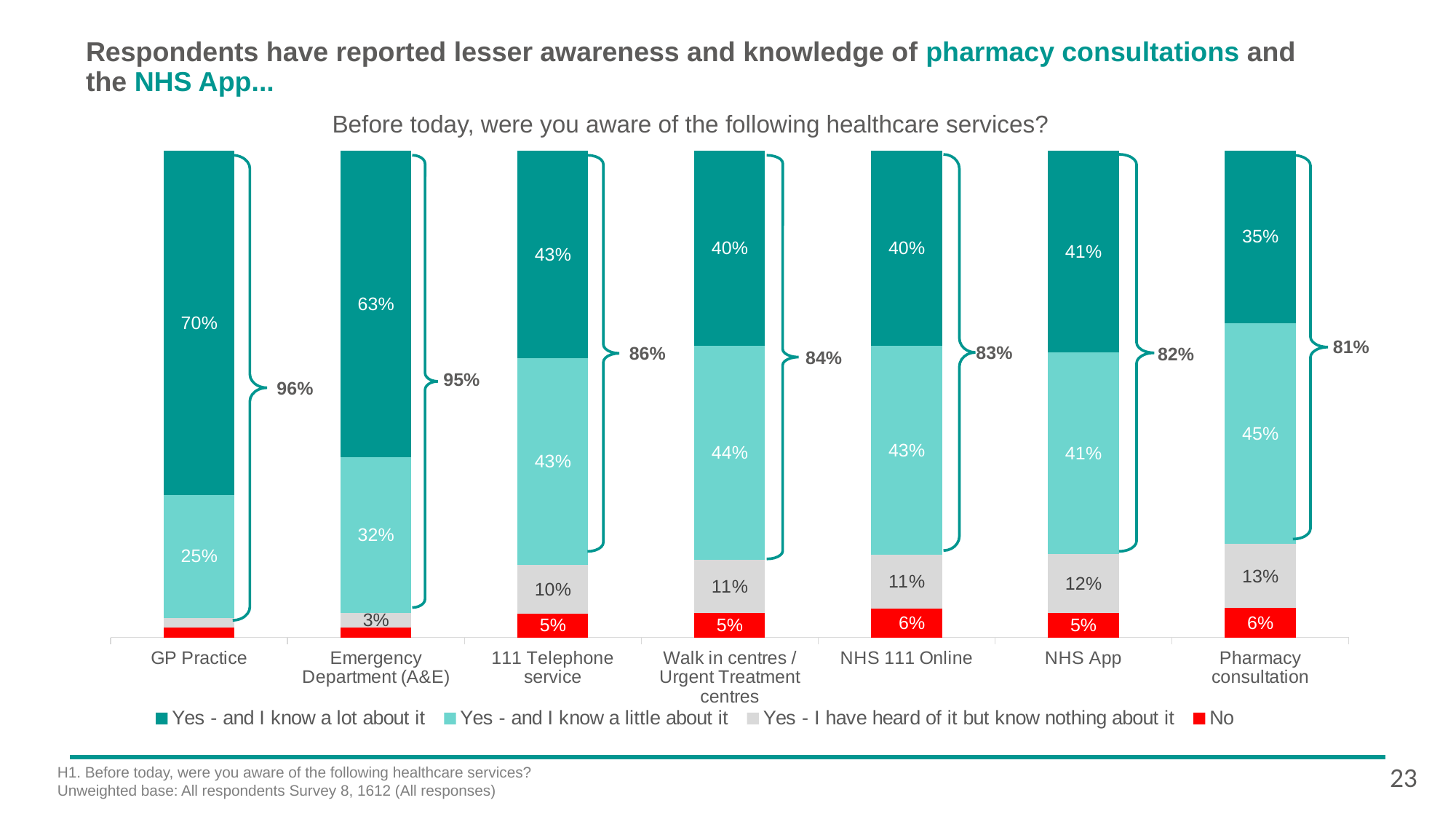
How many response categories does the legend list? 4 Which service has the lowest percentage of respondents saying 'Yes - and I know a lot about it'? Pharmacy consultation What percentage of respondents answered 'No' for NHS 111 Online? 6% What combined percentage is shown by the bracket next to the Walk in centres / Urgent Treatment centres bar? 84% How many healthcare services are shown on the x axis of the chart? 7 What percentage of respondents said 'Yes - and I know a little about it' for Pharmacy consultation? 45% What type of chart is shown on the slide? Stacked bar chart What is the difference in percentage points between the 'Yes - and I know a lot about it' values for GP Practice and Emergency Department (A&E)? 7 percentage points Which service has the highest percentage of respondents saying 'Yes - and I know a lot about it'? GP Practice What percentage of respondents said 'Yes - I have heard of it but know nothing about it' for NHS App? 12% Which is larger: the 'Yes - and I know a little about it' value for Emergency Department (A&E) or for 111 Telephone service? 111 Telephone service What percentage of respondents said 'Yes - and I know a lot about it' for GP Practice? 70%